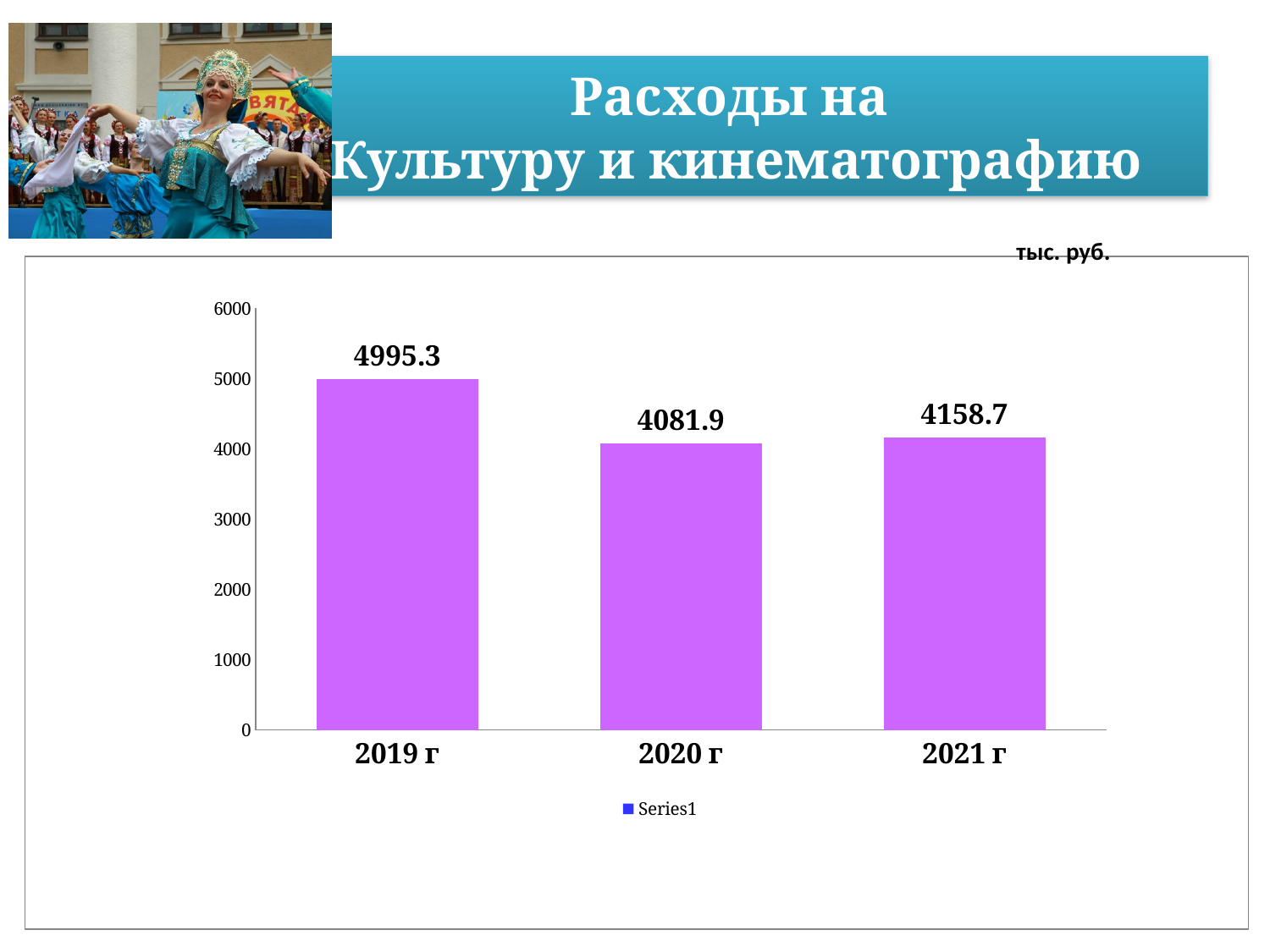
What is the difference between the values for 2021 г and 2020 г? 76.8 Which is larger, the value for 2019 г or the value for 2021 г? 2019 г What is the value for 2019 г? 4995.3 What is the value for 2021 г? 4158.7 How many years are shown on the chart? 3 Which year has the highest value? 2019 г What unit is indicated above the chart? тыс. руб. What kind of chart is shown on the slide? bar chart Which year has the lowest value? 2020 г What is the value for 2020 г? 4081.9 Is the value for 2020 г greater or less than 5000? less What is the difference between the values for 2019 г and 2020 г? 913.4